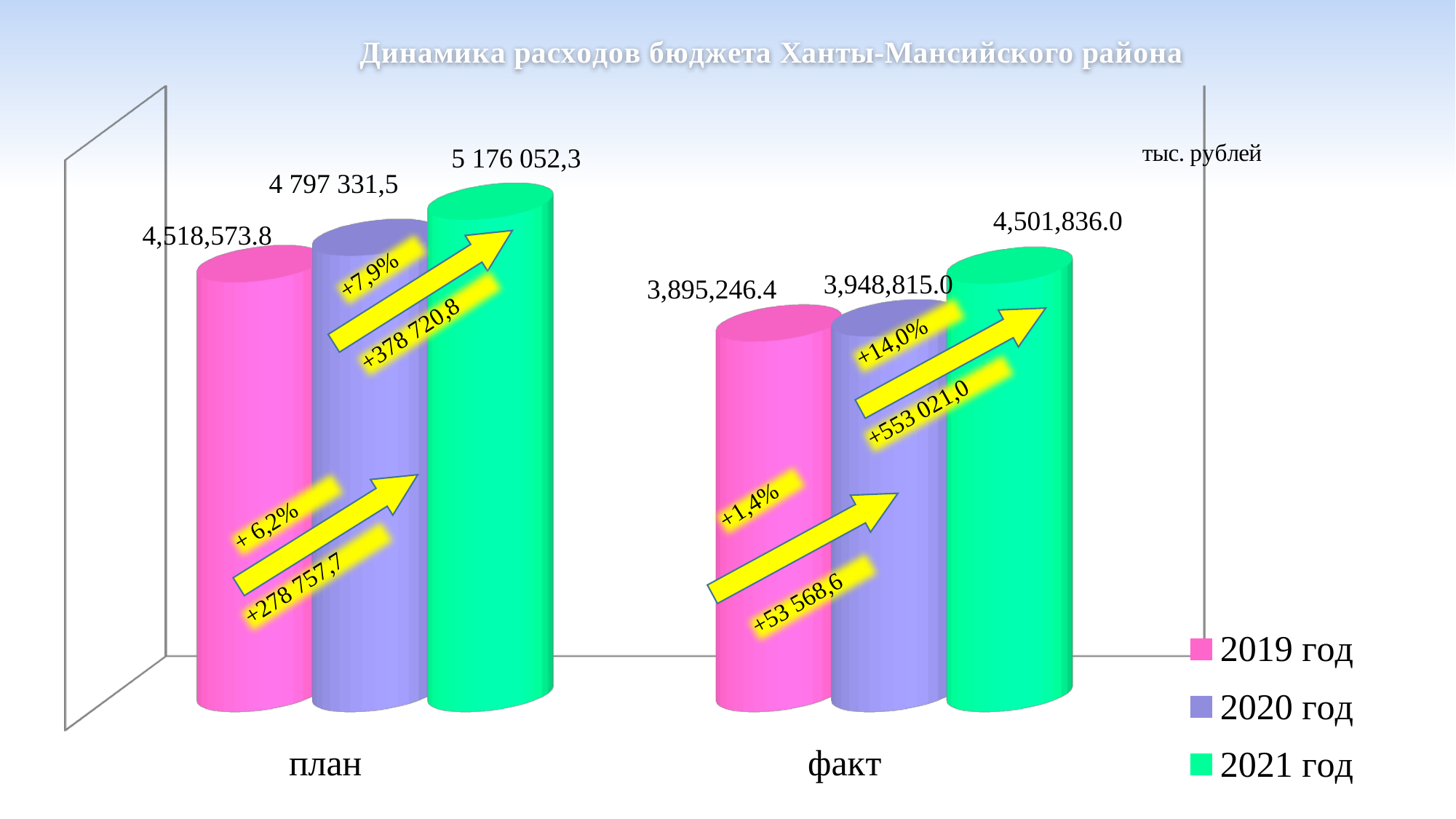
What is the value for 2019 год in the план category? 4,518,573.8 How many series does the legend list? 3 What is the value for 2019 год in the факт category? 3,895,246.4 Which year has the lowest value in the план category? 2019 год What is the value for 2021 год in the план category? 5 176 052,3 Which year has the highest value in the факт category? 2021 год What is the value for 2020 год in the план category? 4 797 331,5 What is the value for 2021 год in the факт category? 4,501,836.0 Which is larger: the 2021 год value for план or the 2021 год value for факт? план What is the difference between the 2021 год and 2020 год values in the факт category, as labelled on the chart? +553 021,0 What is the title of the chart? Динамика расходов бюджета Ханты-Мансийского района What kind of chart is shown on the slide? bar chart